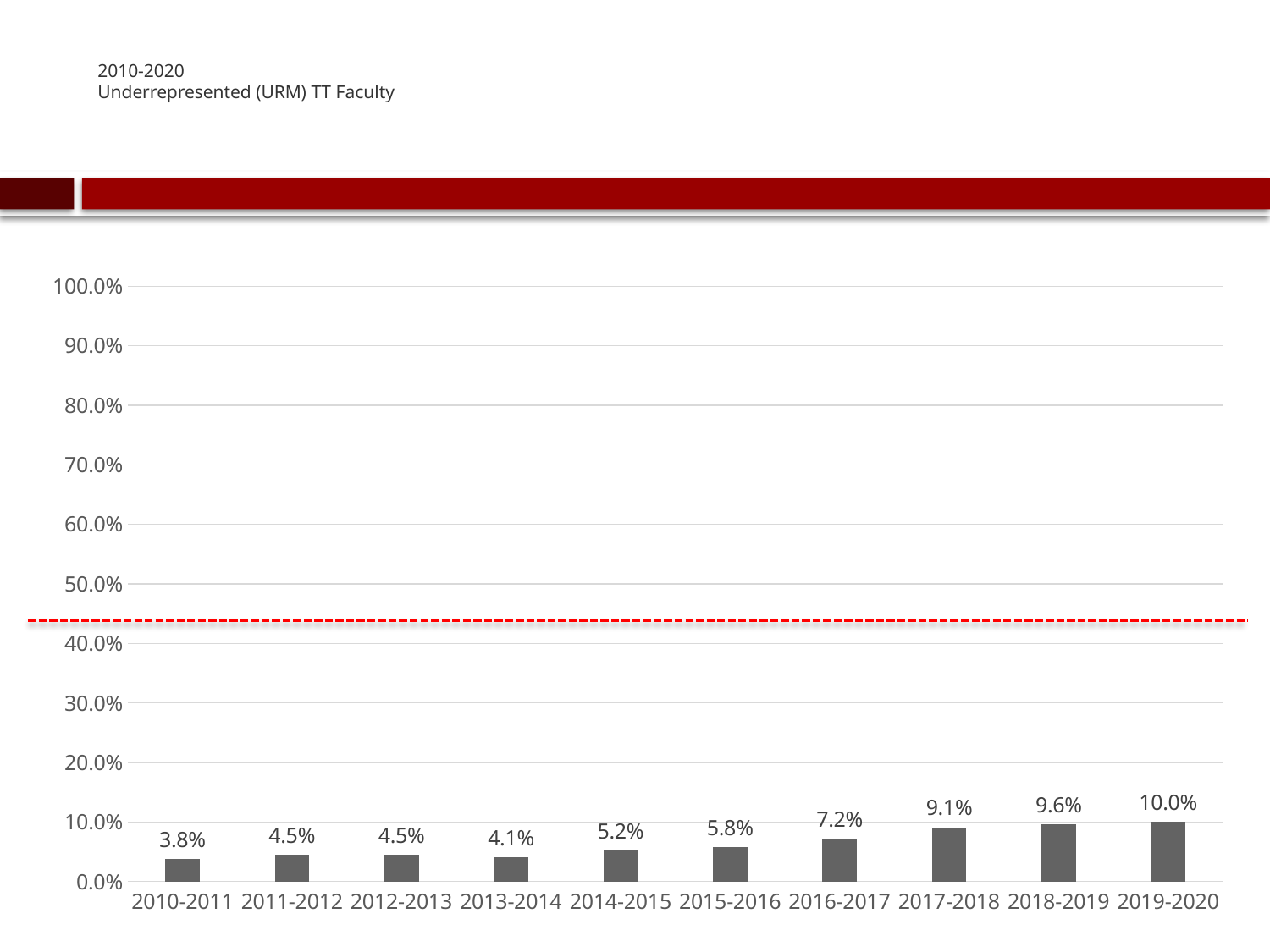
What kind of chart is this? bar chart Which year has the lowest value? 2010-2011 Which is larger, the value for 2013-2014 or the value for 2014-2015? 2014-2015 Which year has the highest value? 2019-2020 What is the value for 2016-2017? 7.2% Do the values generally rise or fall from 2013-2014 to 2019-2020? rise What is the value for 2010-2011? 3.8% What is the value for 2019-2020? 10.0% Is the value for 2018-2019 greater or less than 20.0%? less How many years are shown on the x axis? 10 What is the difference between the values for 2019-2020 and 2010-2011? 6.2% What is the text at the top of the slide describing the chart? 2010-2020 Underrepresented (URM) TT Faculty